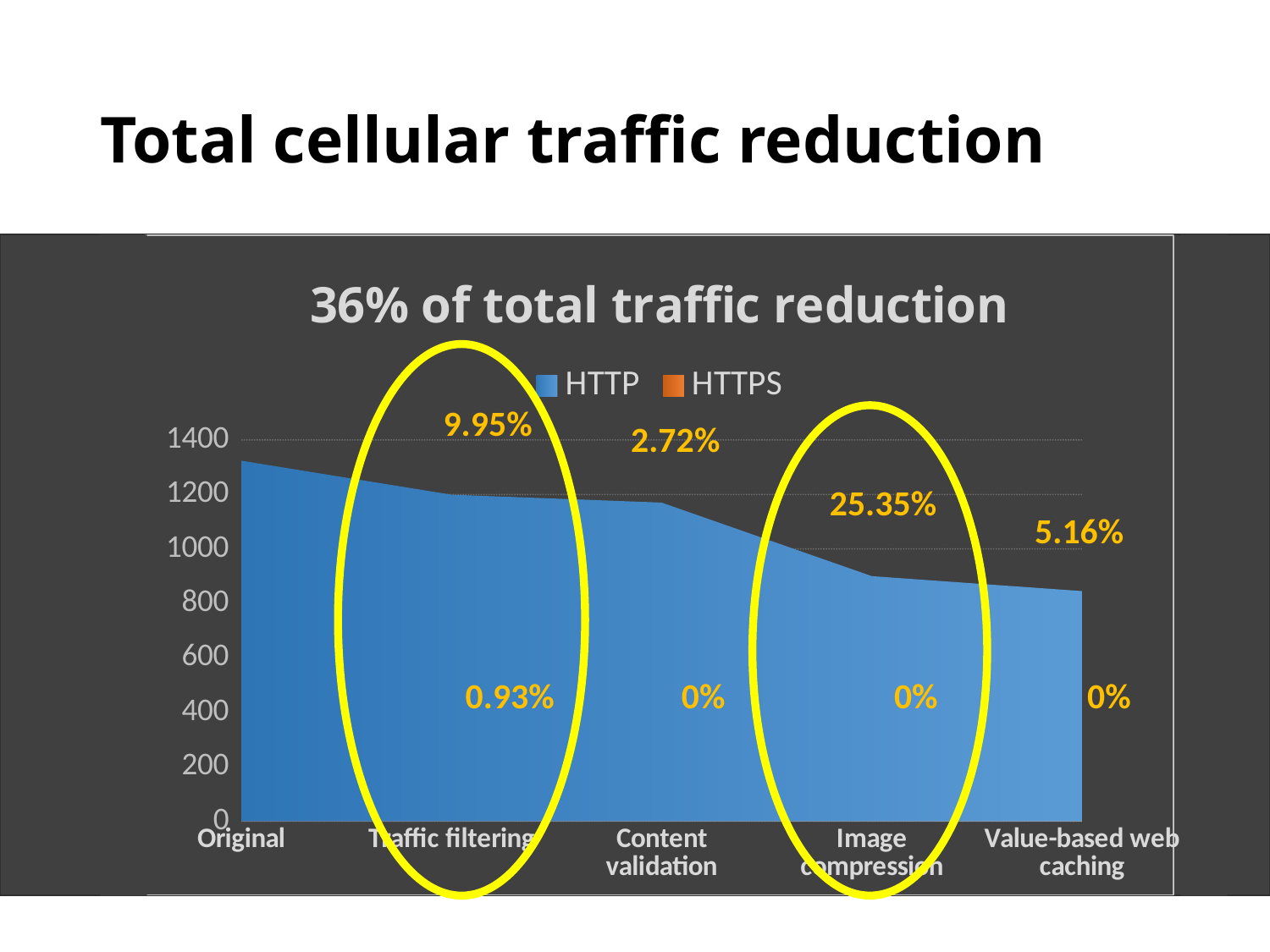
Is the plotted value for Original greater or less than 1200? greater What percentage label is shown in the lower row for the Traffic filtering category? 0.93% What kind of chart is shown on the slide? area chart Which category has the lowest upper-row percentage label? Content validation How many categories are shown along the x axis of the chart? 5 What percentage label is shown in the upper row above the Image compression category? 25.35% How many series does the chart legend list? 2 What percentage label is shown in the upper row above the Value-based web caching category? 5.16% Which category has the highest upper-row percentage label? Image compression Do the plotted values rise or fall from Original to Value-based web caching? fall What percentage label is shown in the upper row above the Traffic filtering category? 9.95% What is the title of the chart? 36% of total traffic reduction